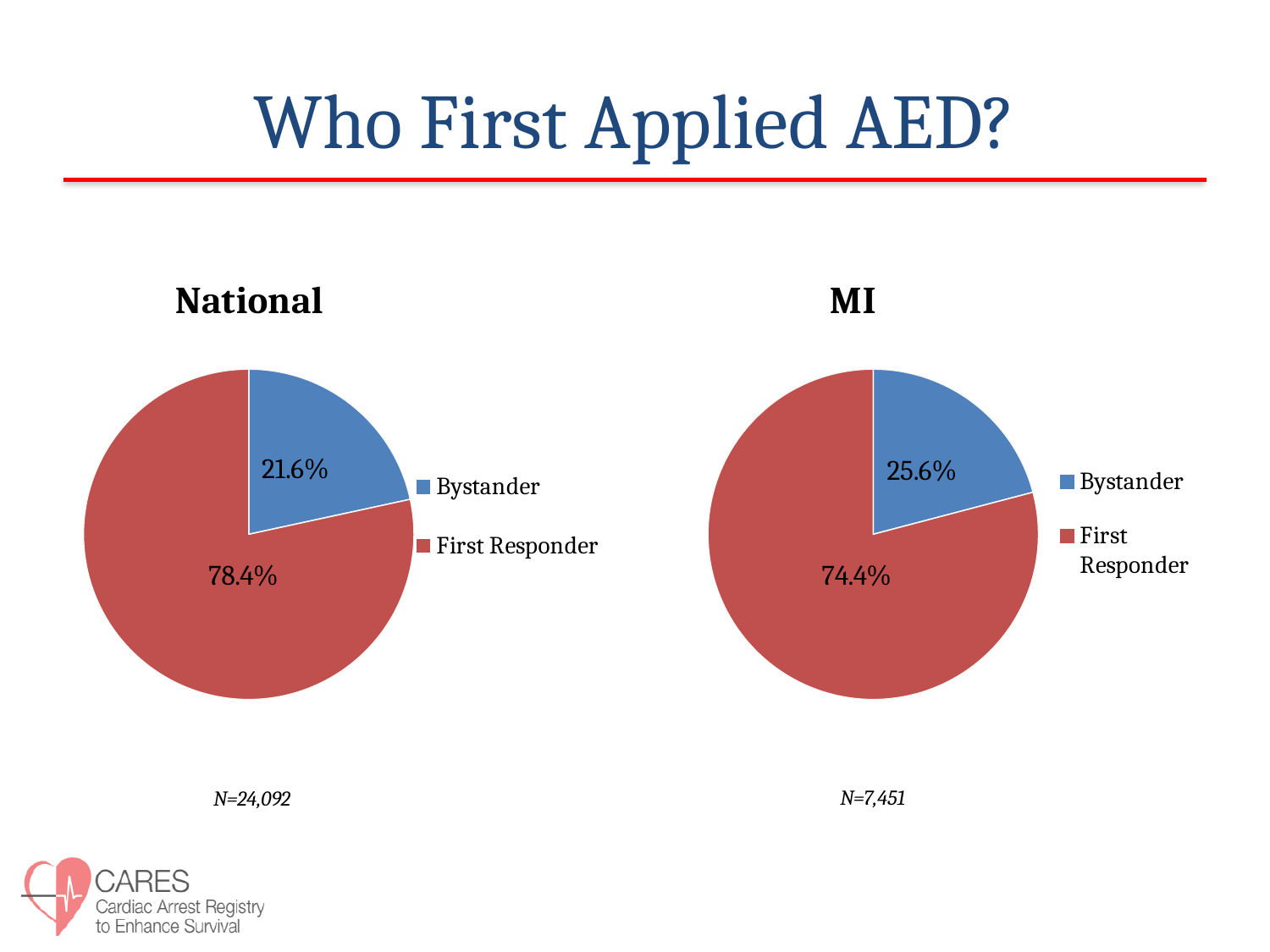
In the National chart, what share of the pie is First Responder? 78.4% In the National chart, what is the difference between the First Responder and Bystander shares? 56.8% In the National chart, what share of the pie is Bystander? 21.6% In the MI chart, which category has the smallest slice? Bystander In the MI chart, what share of the pie is Bystander? 25.6% What kind of chart is the National chart? Pie chart What colour represents First Responder in the MI chart? Red In the National chart, which category has the largest slice? First Responder How many categories does the MI chart show? 2 How many entries does the legend of the National chart list? 2 Is the Bystander share larger in the National chart or the MI chart? MI